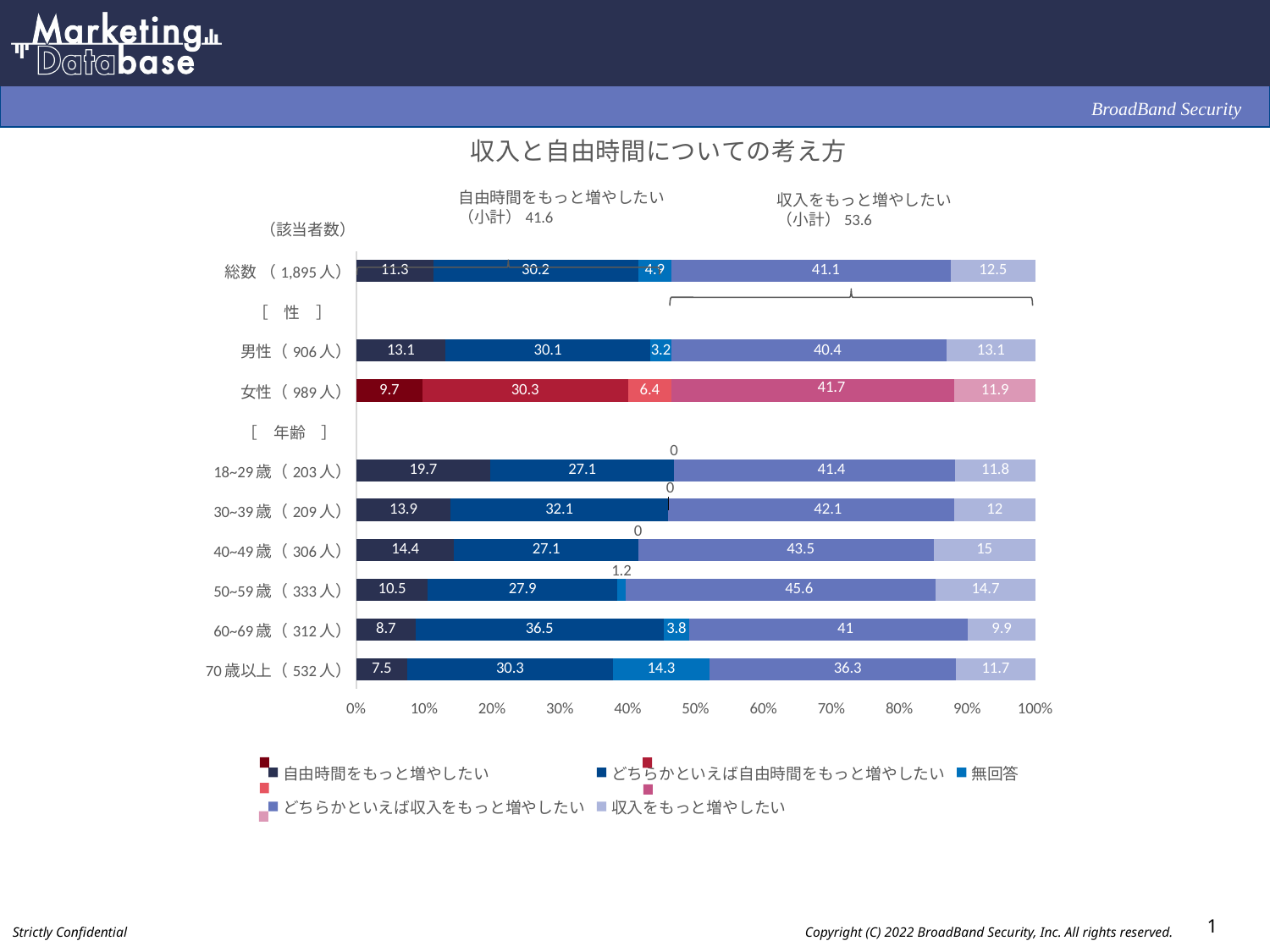
What is the value of 収入をもっと増やしたい for 総数? 12.5 What is the difference between the 自由時間をもっと増やしたい values for 男性 and 女性? 3.4 What type of chart is shown on the slide? Stacked bar chart Which category has the highest value for 自由時間をもっと増やしたい? 18~29歳 What is the value of 無回答 for 70歳以上? 14.3 What is the value of 自由時間をもっと増やしたい for 18~29歳? 19.7 What is the subtotal shown for 収入をもっと増やしたい (小計) above the chart? 53.6 Which is larger, the どちらかといえば自由時間をもっと増やしたい value for 60~69歳 or for 30~39歳? 60~69歳 How many series does the legend list? 5 How many categories (bars) are plotted in the chart? 9 What is the value of どちらかといえば収入をもっと増やしたい for 50~59歳? 45.6 Which category has the lowest value for どちらかといえば収入をもっと増やしたい? 70歳以上